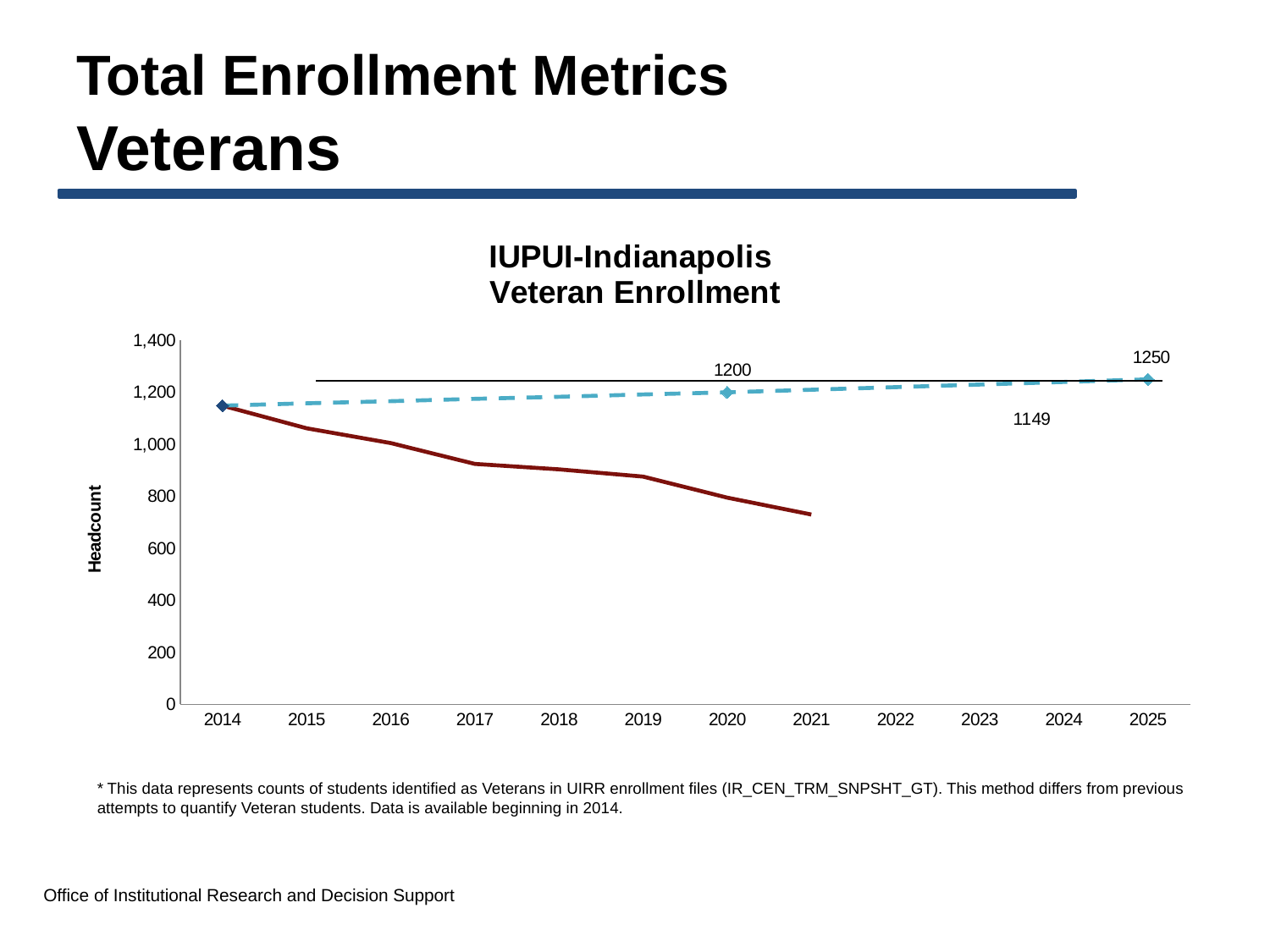
Is the value of the solid dark red line at 2018 greater or less than 800? greater What is the difference between the dashed line's values at 2025 and 2020? 50 What is the value of the dashed line at 2020? 1200 Is the value of the solid dark red line at 2021 greater or less than 800? less What kind of chart is shown on the slide? line chart How many years are labeled on the x axis? 12 Does the solid dark red line rise or fall from 2014 to 2021? fall What is the value of the dashed line at 2025? 1250 What is the title of the y axis? Headcount Is the value of the solid dark red line at 2019 greater or less than 1,000? less Does the dashed line rise or fall from 2014 to 2025? rise Which is larger, the dashed line's value at 2020 or at 2025? 2025